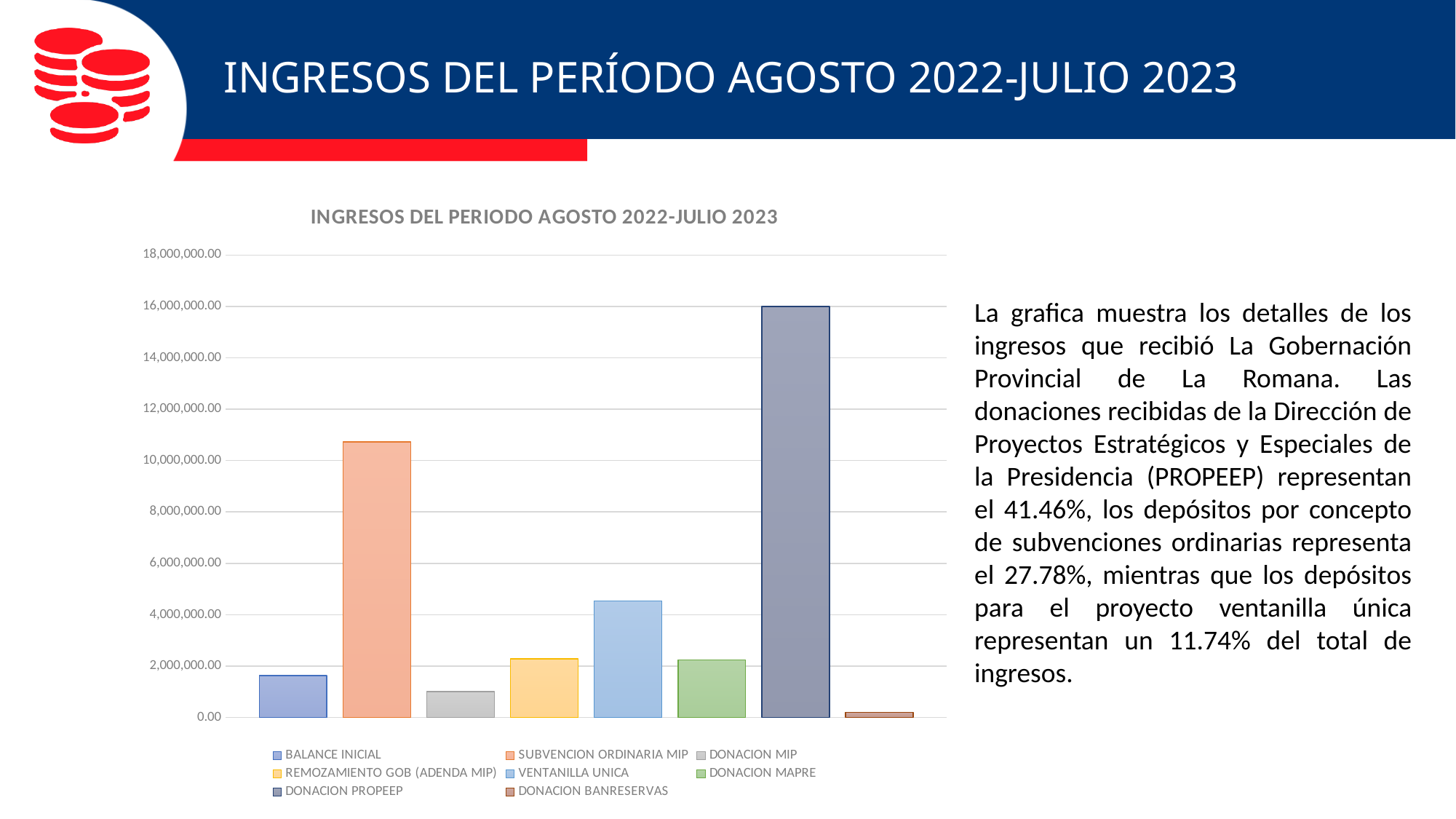
What is the title of the chart? INGRESOS DEL PERIODO AGOSTO 2022-JULIO 2023 Is the value for BALANCE INICIAL greater or less than 2,000,000.00? less Which category has the lowest value in the chart? DONACION BANRESERVAS Is the value for VENTANILLA UNICA greater or less than 4,000,000.00? greater What kind of chart is shown on the slide? Bar chart Is the value for DONACION PROPEEP greater or less than 14,000,000.00? greater How many series does the legend list? 8 Which is larger, the value for BALANCE INICIAL or the value for DONACION MIP? BALANCE INICIAL Which is larger, the value for SUBVENCION ORDINARIA MIP or the value for VENTANILLA UNICA? SUBVENCION ORDINARIA MIP How many bars are plotted in the chart? 8 Which category has the highest value in the chart? DONACION PROPEEP